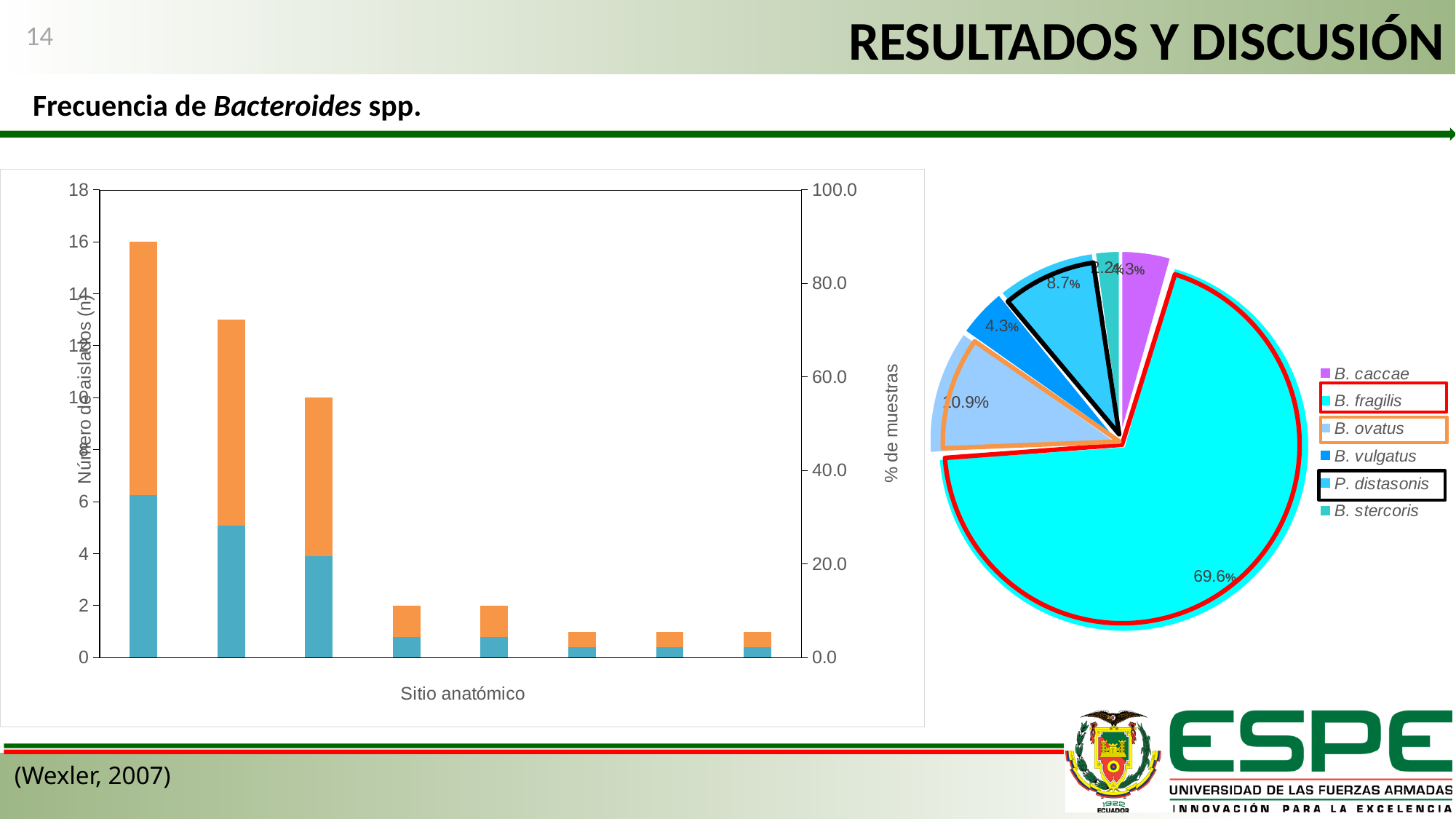
In the pie chart on the right, what share does P. distasonis have? 8.7% What kind of chart is the chart on the left of the slide? bar chart In the bar chart on the left, how many bars are plotted? 8 What kind of chart is the chart on the right of the slide? pie chart In the pie chart on the right, how many species does the legend list? 6 In the pie chart on the right, which species has the largest slice? B. fragilis In the bar chart on the left, what is the title of the x axis? Sitio anatómico In the bar chart on the left, what is the title of the right-hand y axis? % de muestras In the bar chart on the left, do the bar heights rise or fall from left to right? fall In the pie chart on the right, what share does B. fragilis have? 69.6% In the pie chart on the right, which species has the smallest slice? B. stercoris In the pie chart on the right, what share does B. ovatus have? 10.9%